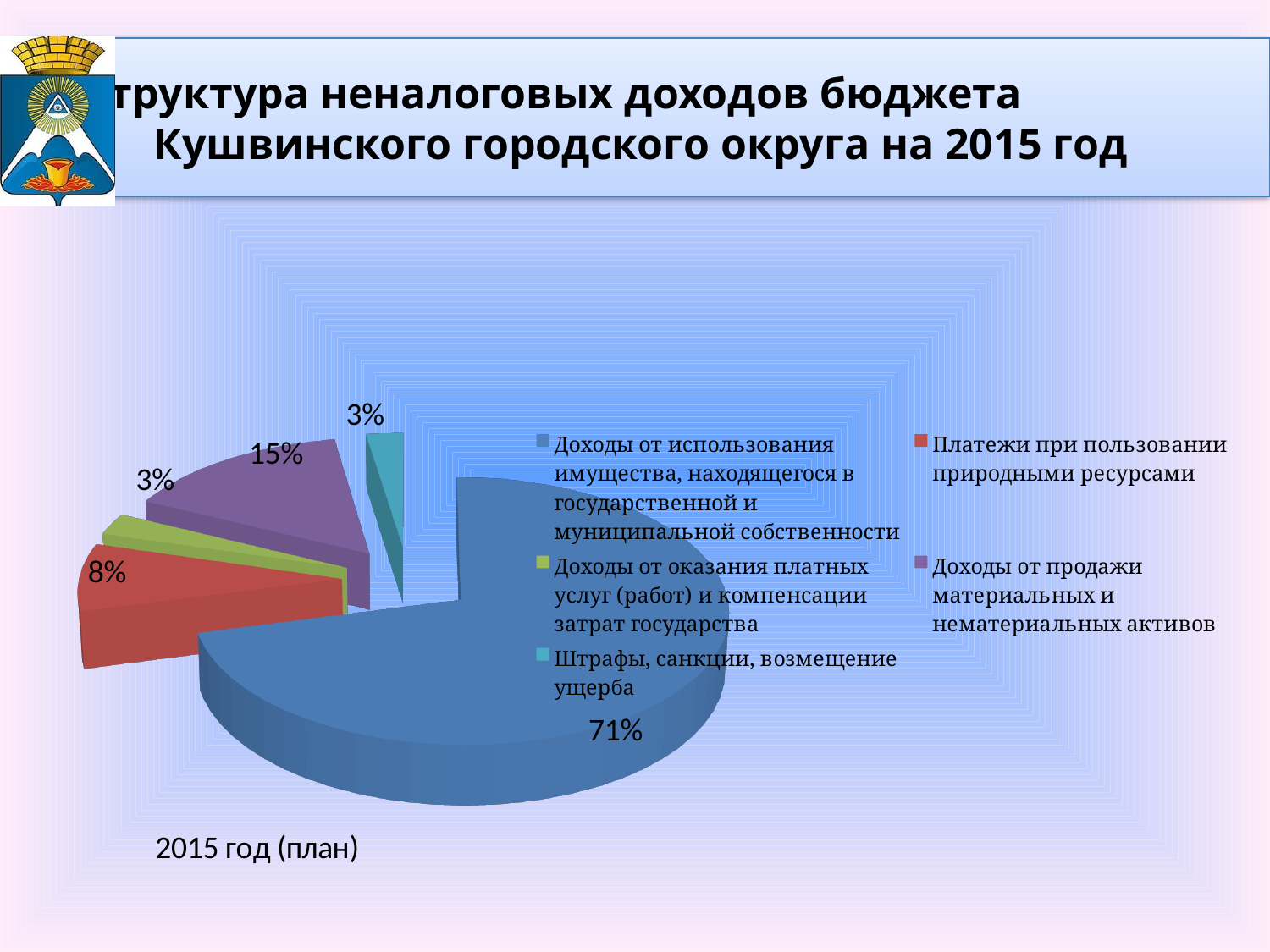
How many entries does the legend list? 5 What kind of chart is shown on the slide? pie chart How many slices does the pie chart have? 5 What share of the pie is labelled for 'Платежи при пользовании природными ресурсами'? 8% Which category has the largest slice of the pie? Доходы от использования имущества, находящегося в государственной и муниципальной собственности What label appears below the pie chart? 2015 год (план) Which is larger: the slice for 'Платежи при пользовании природными ресурсами' or the slice for 'Доходы от оказания платных услуг (работ) и компенсации затрат государства'? Платежи при пользовании природными ресурсами What is the smallest percentage shown on the pie chart? 3% What share of the pie is labelled for 'Доходы от продажи материальных и нематериальных активов'? 15% What share of the pie is labelled for 'Доходы от использования имущества, находящегося в государственной и муниципальной собственности'? 71% What is the difference in percentage points between the slice for 'Доходы от продажи материальных и нематериальных активов' and the slice for 'Платежи при пользовании природными ресурсами'? 7 percentage points What share of the pie is labelled for 'Штрафы, санкции, возмещение ущерба'? 3%